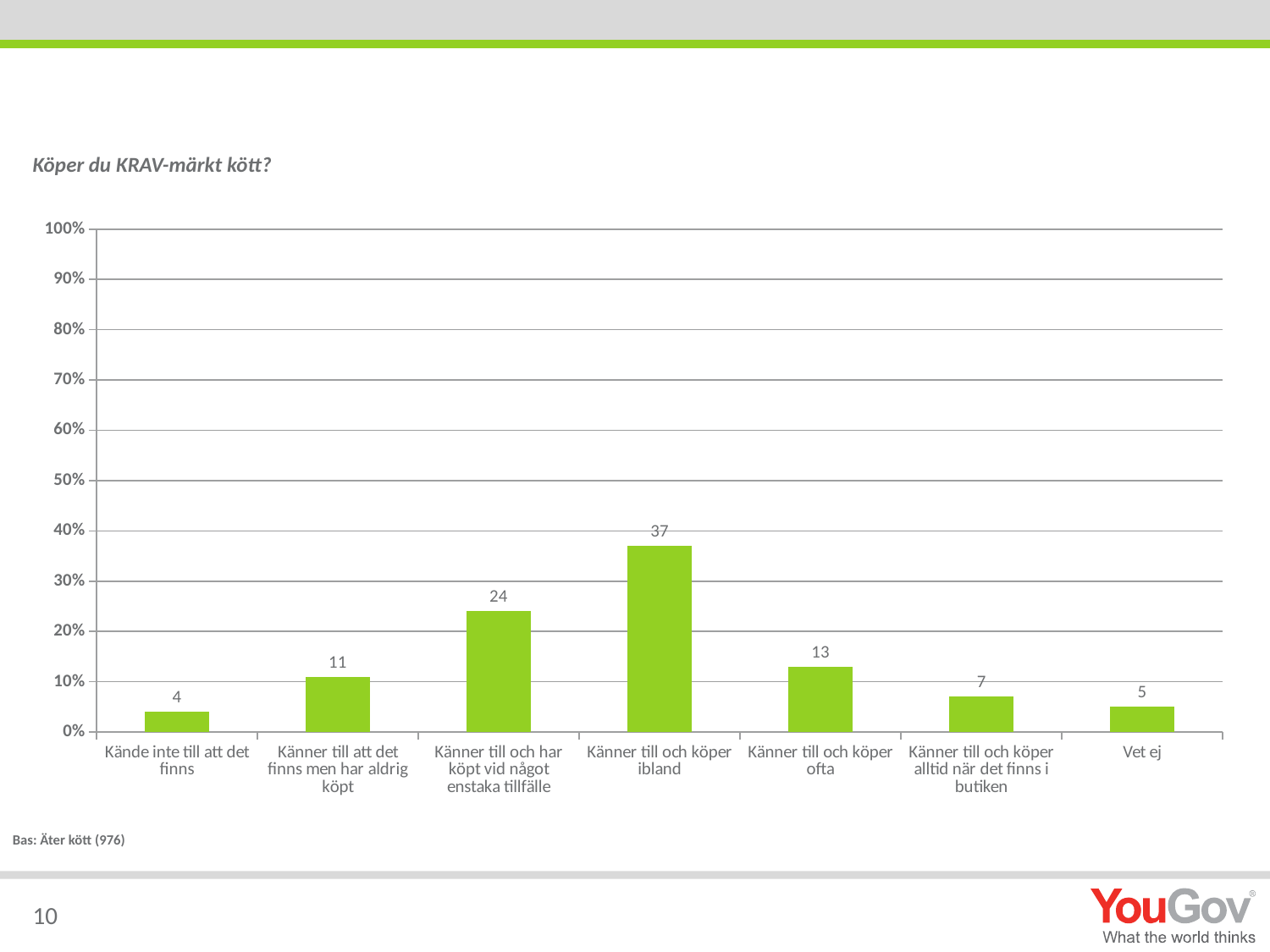
Which is larger, the value for "Känner till och köper ofta" or the value for "Känner till att det finns men har aldrig köpt"? Känner till och köper ofta Which category has the highest value? Känner till och köper ibland What is the difference between the values for "Känner till och köper ibland" and "Känner till och har köpt vid något enstaka tillfälle"? 13 What is the value for "Kände inte till att det finns"? 4 How many categories are shown on the x axis? 7 What is the value for "Vet ej"? 5 Is the value for "Känner till och har köpt vid något enstaka tillfälle" greater or less than 20%? greater What is the title of the chart? Köper du KRAV-märkt kött? Which category has the lowest value? Kände inte till att det finns What kind of chart is shown on the slide? bar chart What is the value for "Känner till och köper ibland"? 37 What is the value for "Känner till och köper alltid när det finns i butiken"? 7